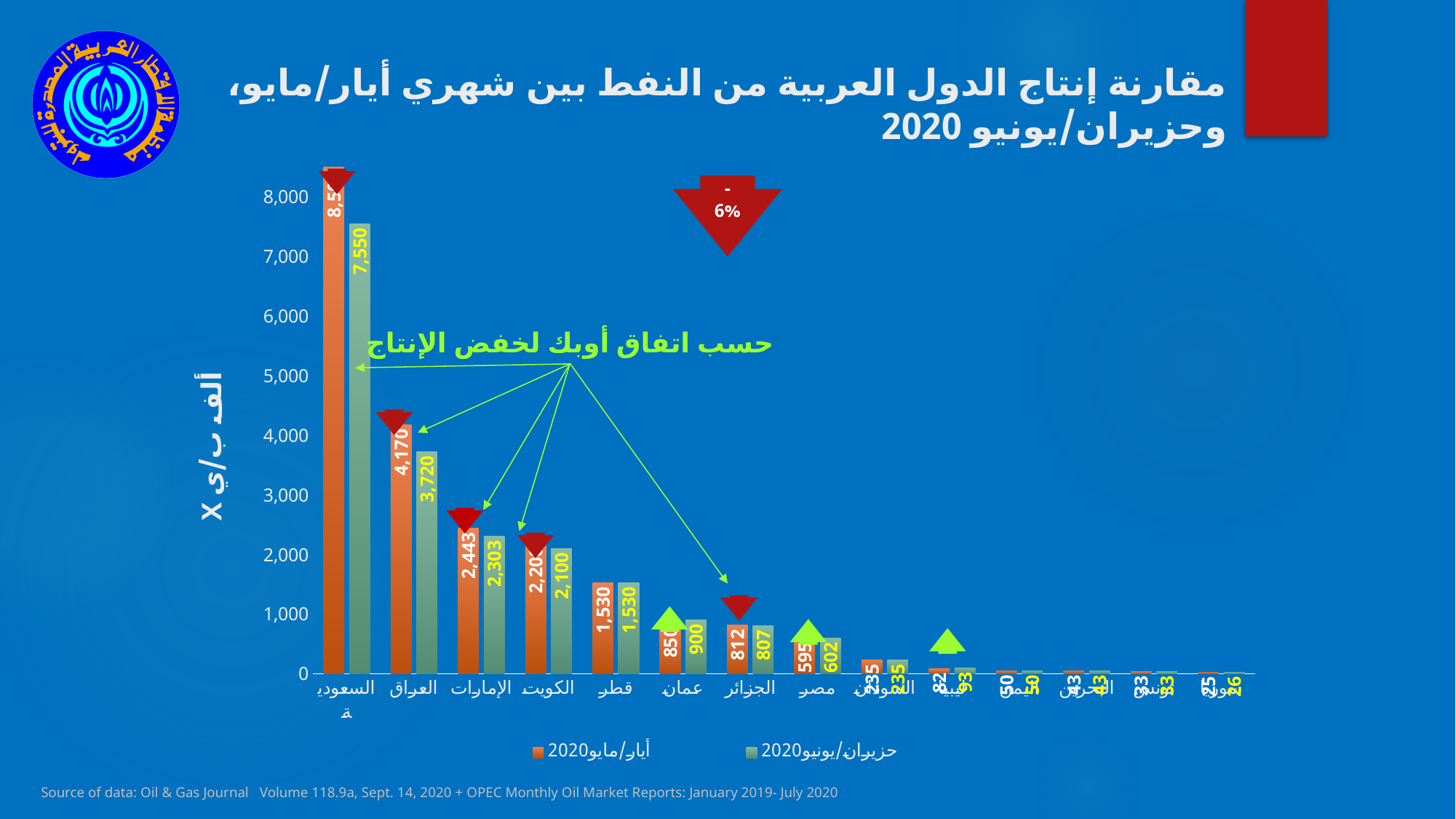
What is the value for العراق (Iraq) in the حزيران/يونيو 2020 series? 3,720 What is the value for قطر (Qatar) in the أيار/مايو 2020 series? 1,530 How many series does the legend list? 2 What is the difference between the أيار/مايو 2020 and حزيران/يونيو 2020 values for الإمارات (UAE)? 140 How many countries are shown on the x axis of the chart? 14 What is the difference between the أيار/مايو 2020 and حزيران/يونيو 2020 values for العراق (Iraq)? 450 What is the value for الإمارات (UAE) in the أيار/مايو 2020 series? 2,443 What kind of chart is shown on the slide? Bar chart Which country has the highest value in the حزيران/يونيو 2020 series? السعودية For عمان (Oman), which series has the larger value, أيار/مايو 2020 or حزيران/يونيو 2020? حزيران/يونيو 2020 What is the value for الجزائر (Algeria) in the أيار/مايو 2020 series? 812 What is the value for عمان (Oman) in the حزيران/يونيو 2020 series? 900